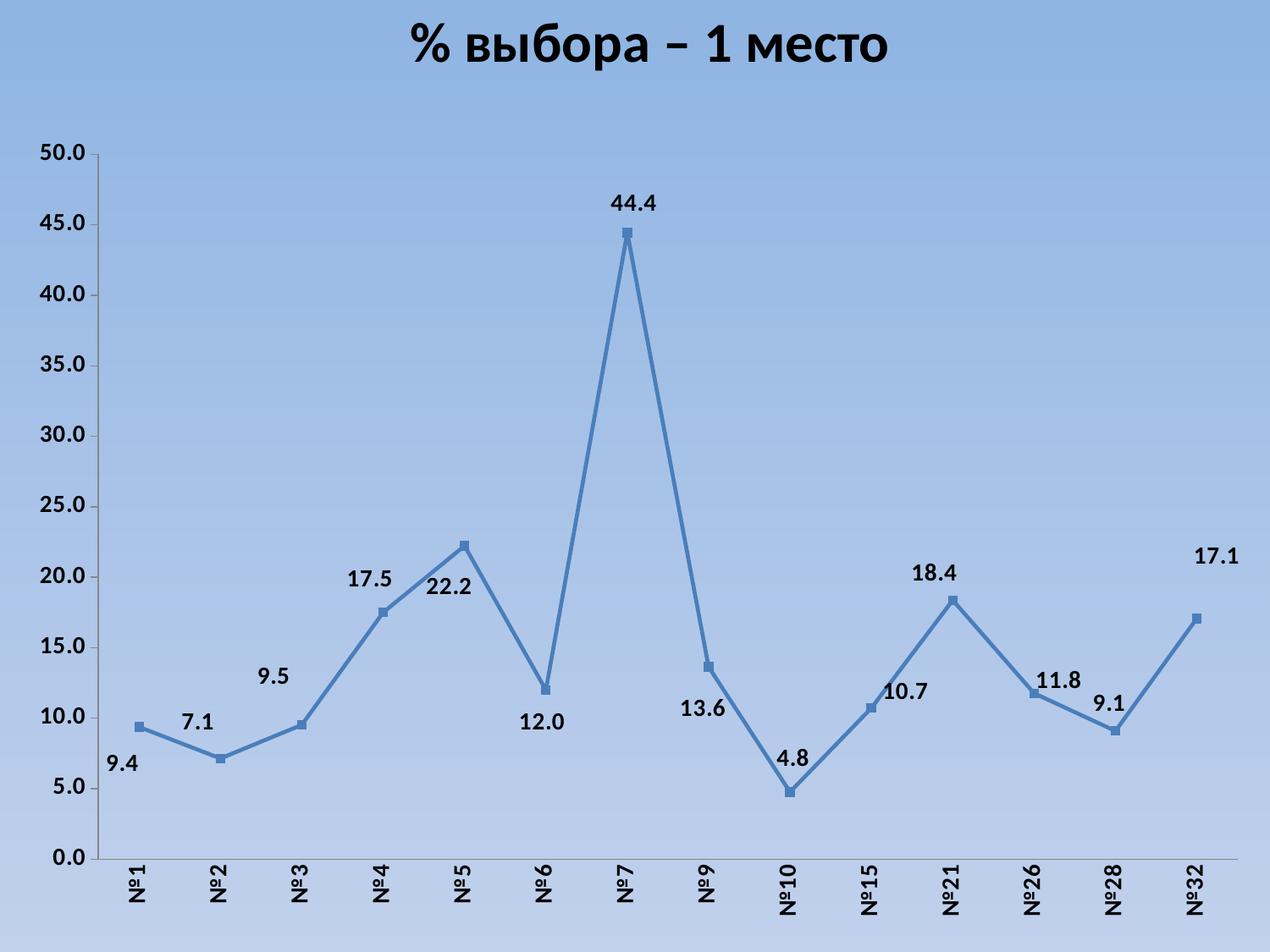
How many categories are shown on the x axis? 14 Is the value for №7 greater or less than 40.0? greater What is the difference between the values for №7 and №5? 22.2 Which category has the lowest value? №10 What is the value for №10? 4.8 Which is larger, the value for №4 or the value for №9? №4 What kind of chart is shown on the slide? line chart What is the value for №21? 18.4 What is the value for №7? 44.4 What is the difference between the values for №32 and №28? 8.0 Which category has the highest value? №7 What is the title of the chart? % выбора – 1 место